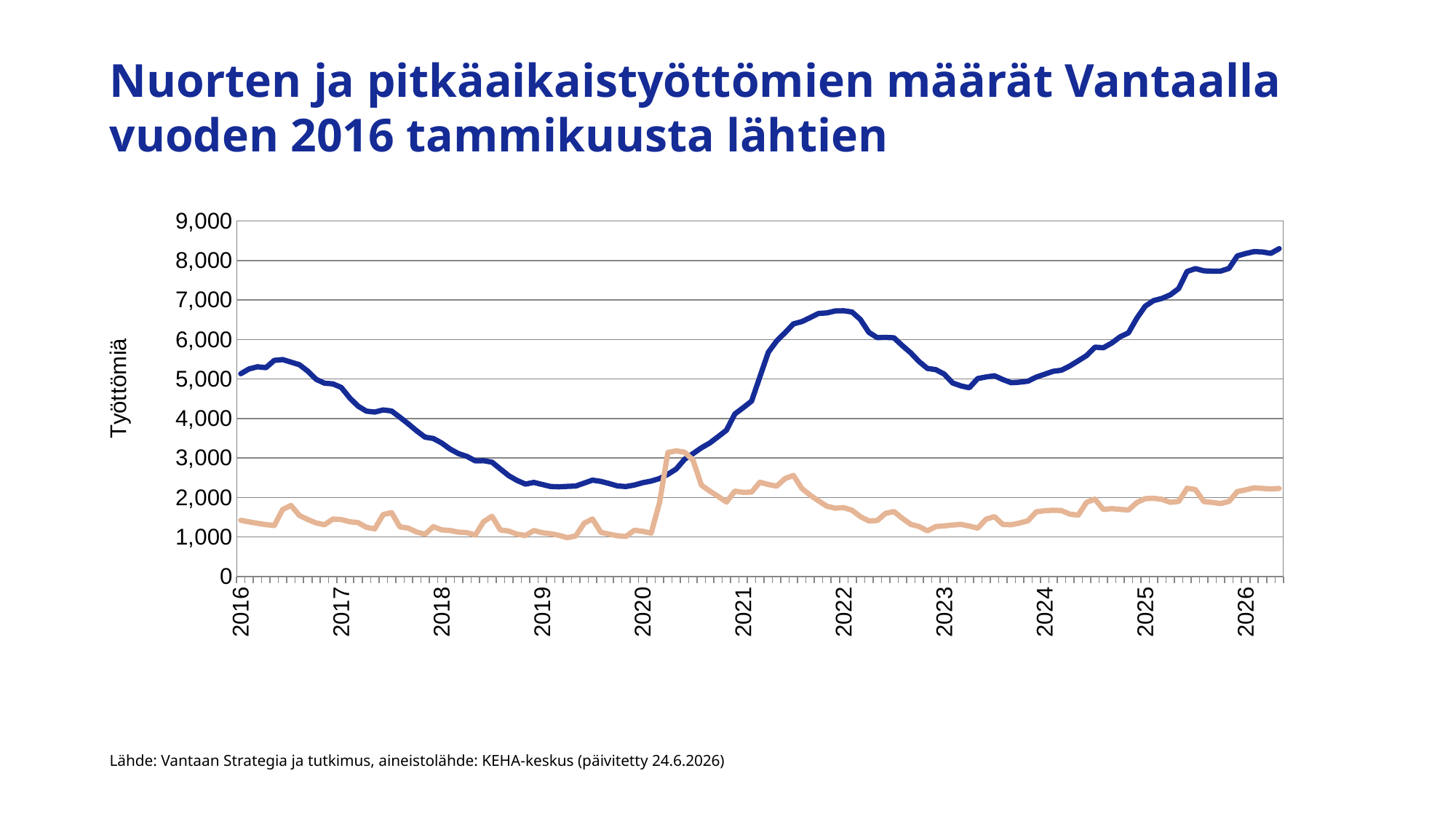
Is the value of the dark blue line at the start of 2026 greater or less than 8,000? greater What kind of chart is shown on the slide? line chart What is the label on the vertical axis? Työttömiä Does the dark blue line rise or fall between 2023 and 2026? rise How many lines are plotted on the chart? 2 At the start of 2024, which line has the higher value, the dark blue line or the light orange line? the dark blue line What is the title of the chart on the slide? Nuorten ja pitkäaikaistyöttömien määrät Vantaalla vuoden 2016 tammikuusta lähtien Is the value of the dark blue line at the start of 2022 greater or less than 6,000? greater Is the peak of the light orange line in 2020 greater or less than 2,000? greater Does the dark blue line rise or fall between 2016 and 2019? fall